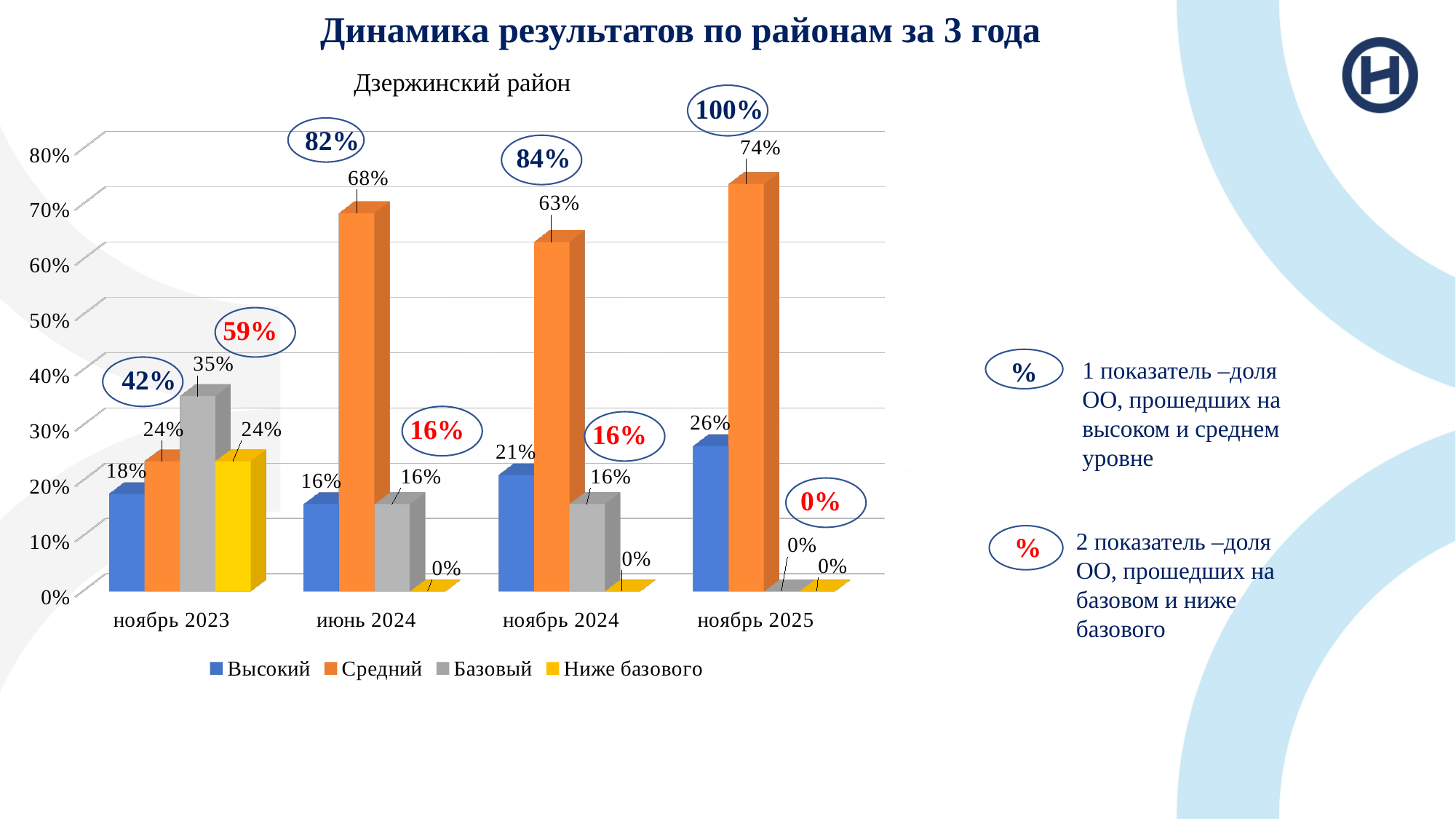
How many series does the legend list? 4 In which period is the Средний series highest? ноябрь 2025 How many periods are shown on the x axis? 4 What is the value for Ниже базового in ноябрь 2024? 0% What is the difference between the Средний values for ноябрь 2025 and ноябрь 2024? 11% What is the value for Высокий in июнь 2024? 16% In which period is the Высокий series lowest? июнь 2024 Does the Средний series rise or fall from ноябрь 2024 to ноябрь 2025? rise Which is larger: Высокий in ноябрь 2024 or Высокий in ноябрь 2025? ноябрь 2025 What kind of chart is shown? bar chart What is the value for Базовый in ноябрь 2023? 35% What is the value for Средний in ноябрь 2025? 74%